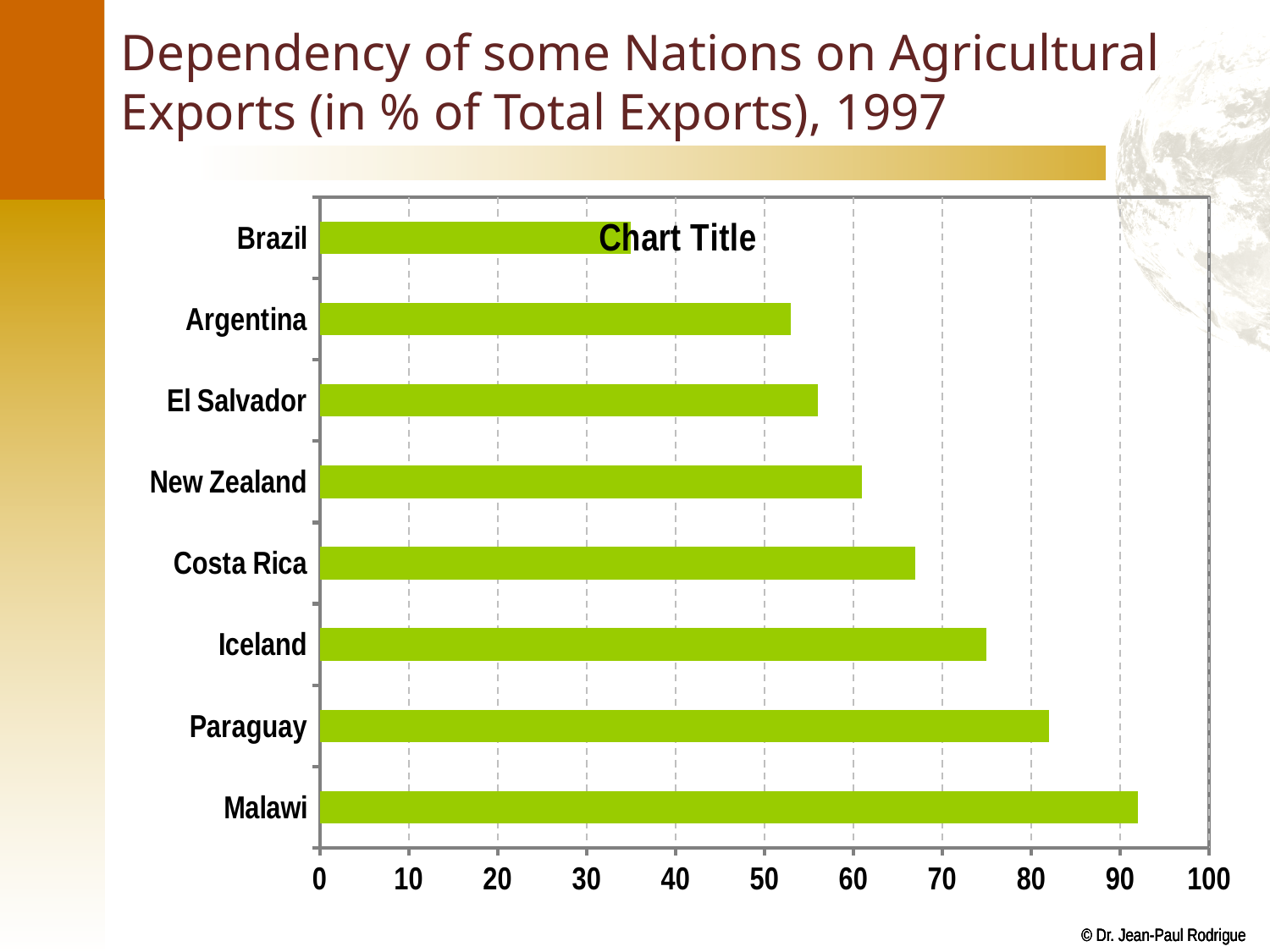
Which country has the lowest share of agricultural exports in the chart? Brazil Which country has the highest share of agricultural exports in the chart? Malawi What kind of chart is shown on the slide? bar chart Is the value for Brazil greater or less than 40? less Is the value for Costa Rica greater or less than 70? less Is the value for Malawi greater or less than 80? greater What colour are the bars in the chart? green How many countries are shown in the chart? 8 Which is larger, the value for Paraguay or the value for Iceland? Paraguay Which is larger, the value for Costa Rica or the value for New Zealand? Costa Rica